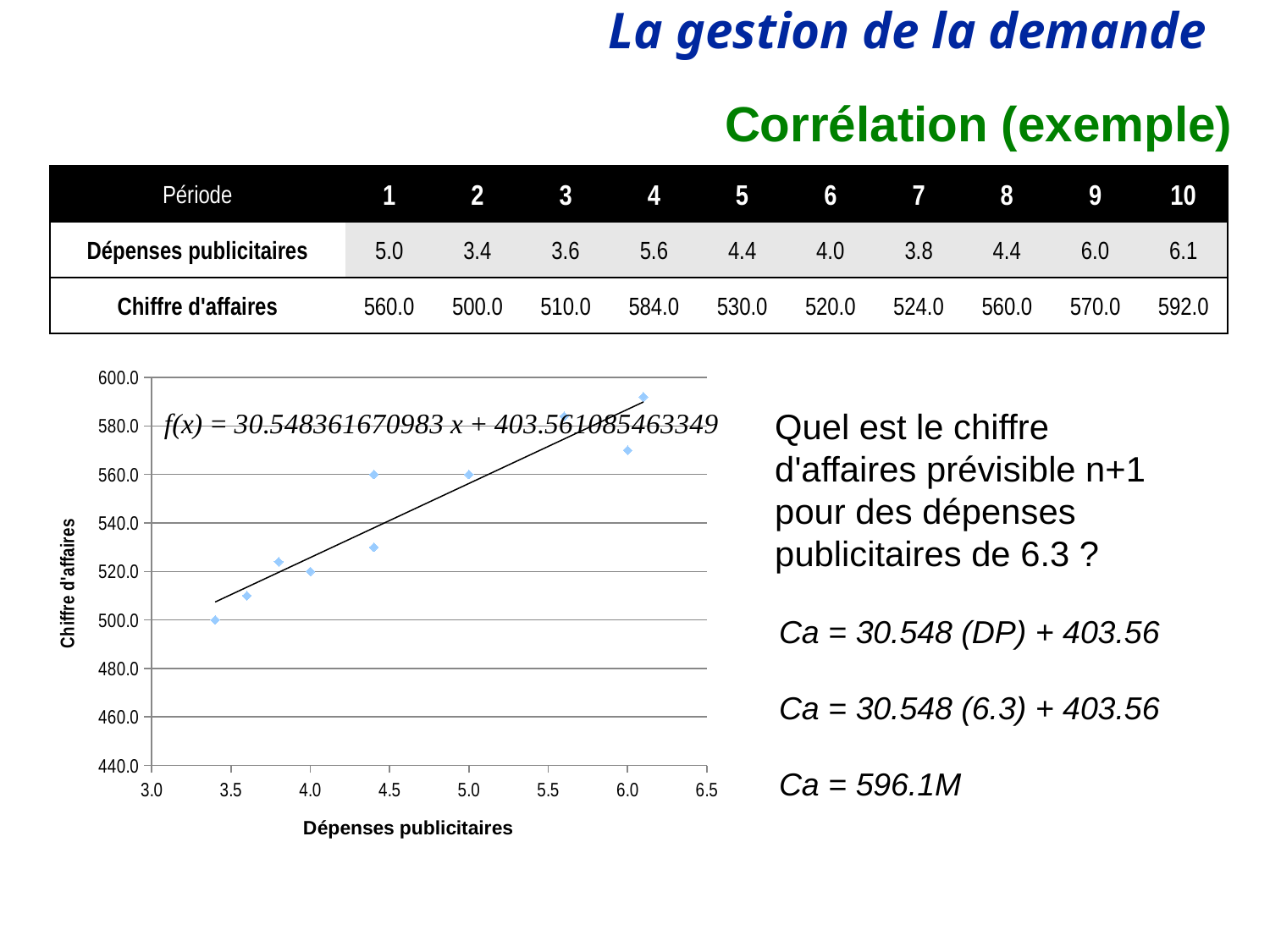
What is the highest chiffre d'affaires value plotted in the chart? 592.0 What is the chiffre d'affaires for dépenses publicitaires of 3.4? 500.0 Does the chiffre d'affaires generally rise or fall as dépenses publicitaires increase along the x axis? rise Which has a larger chiffre d'affaires: dépenses publicitaires of 6.0 or 6.1? 6.1 Is the chiffre d'affaires for dépenses publicitaires of 3.8 greater or less than 540.0? less What is the difference between the highest and lowest chiffre d'affaires values plotted? 92.0 What is the lowest chiffre d'affaires value plotted in the chart? 500.0 What is the chiffre d'affaires for dépenses publicitaires of 5.6? 584.0 What is the label of the y axis of the chart? Chiffre d'affaires What is the label of the x axis of the chart? Dépenses publicitaires What kind of chart is shown on the slide? scatter chart How many data points are plotted in the scatter chart? 10